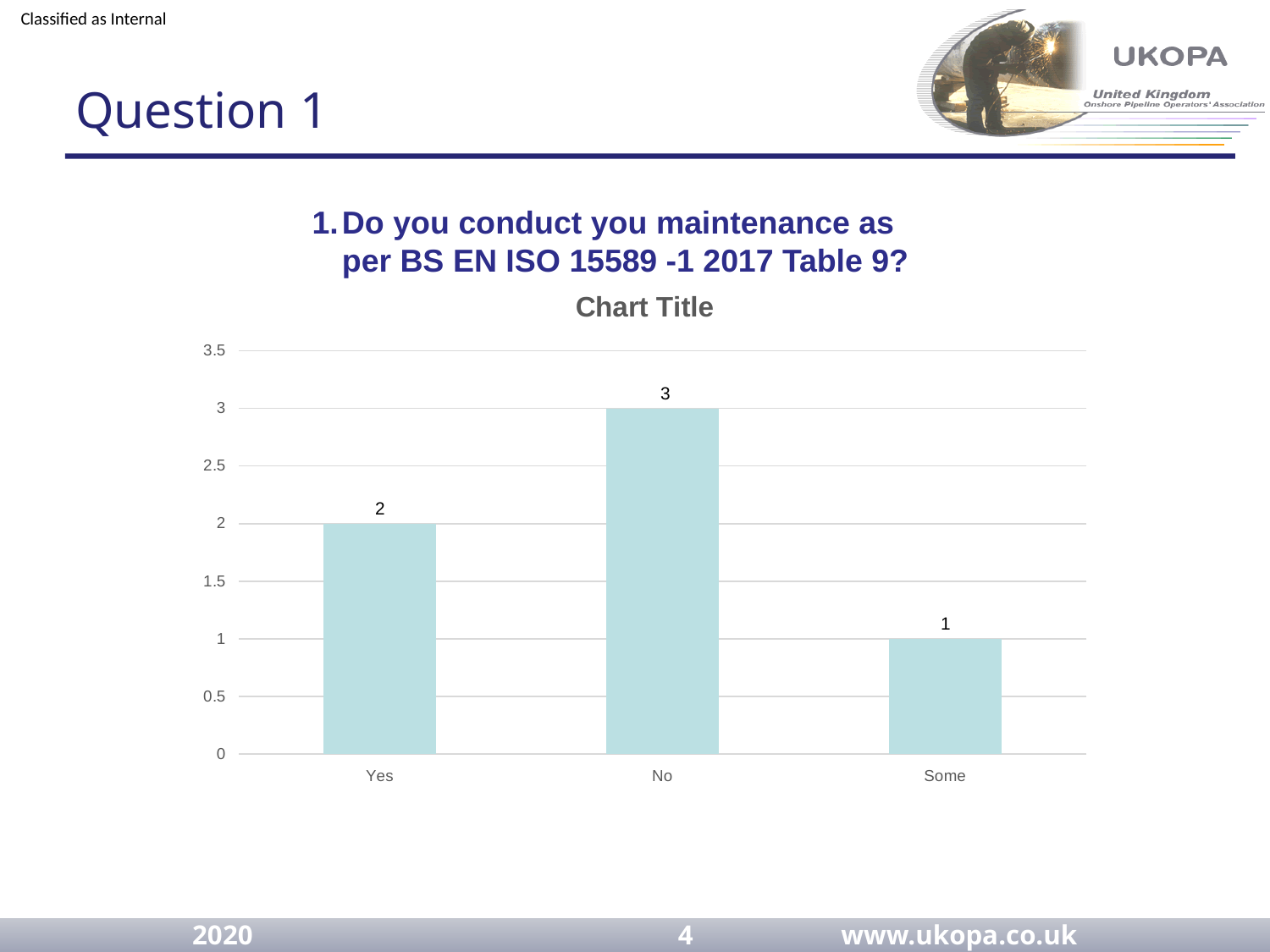
What is the difference between the values for Yes and Some? 1 What is the difference between the values for No and Yes? 1 Which category has the highest value? No Which category has the lowest value? Some What kind of chart is shown on the slide? bar chart Which is larger, the value for Yes or the value for Some? Yes What is the title shown above the chart? Chart Title What is the value for No? 3 Is the value for No greater or less than 2.5? greater What is the value for Some? 1 What is the value for Yes? 2 How many categories are shown on the x axis? 3